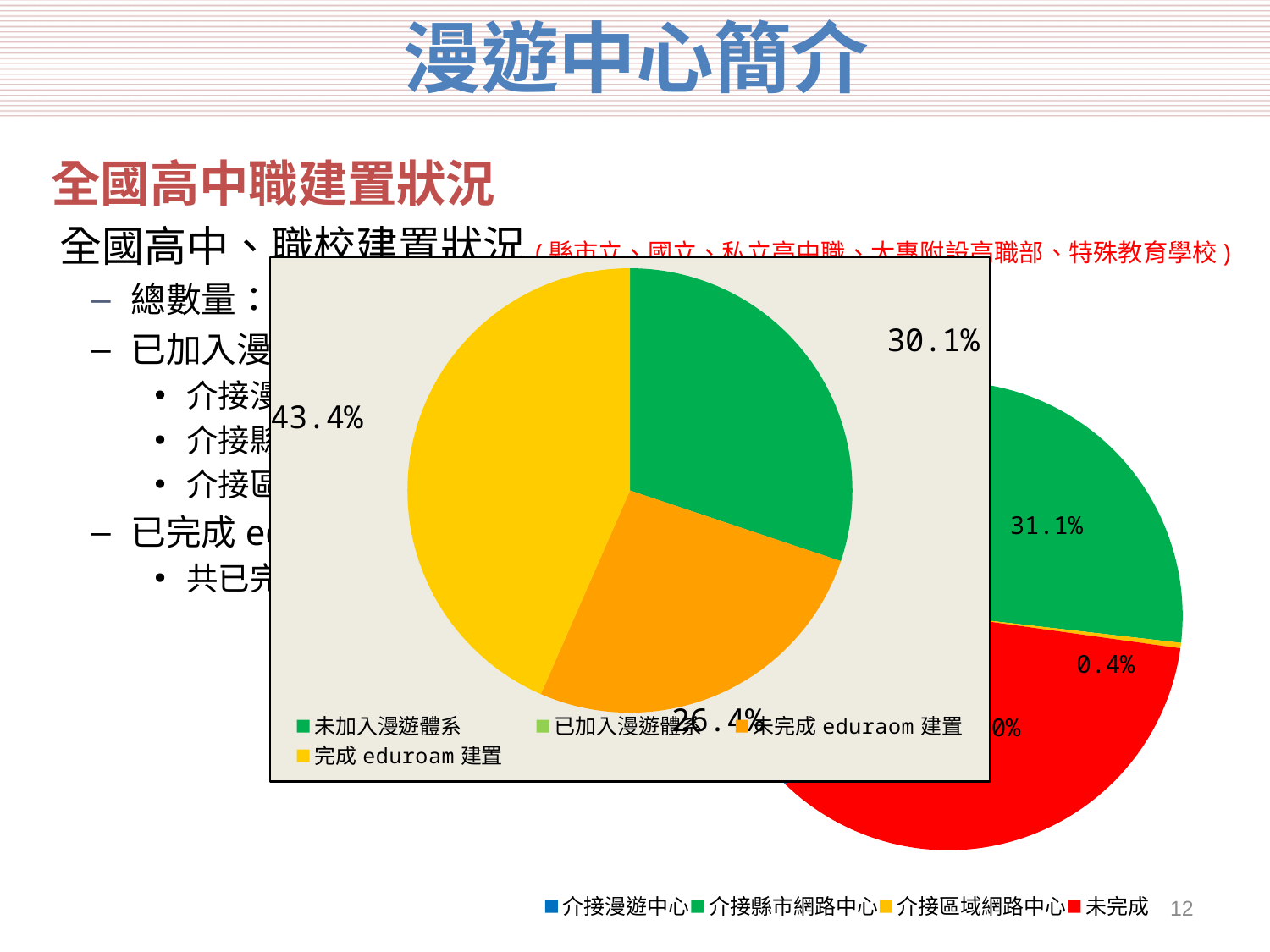
In the back pie chart (partially hidden, lower right), what percentage is shown for 介接縣市網路中心? 31.1% In the front pie chart (beige background), what is the difference in percentage points between 完成 eduroam 建置 and 未加入漫遊體系? 13.3 percentage points What type of chart is the front chart with the beige background? Pie chart In the front pie chart (beige background), which is larger: 未加入漫遊體系 or 未完成 eduraom 建置? 未加入漫遊體系 In the front pie chart (beige background), what percentage is shown for 未加入漫遊體系? 30.1% In the front pie chart (beige background), what percentage is shown for 未完成 eduraom 建置? 26.4% In the front pie chart (beige background), what percentage is shown for 完成 eduroam 建置? 43.4% In the back pie chart (partially hidden, lower right), what percentage is shown for 介接區域網路中心? 0.4% In the front pie chart (beige background), what colour is the 完成 eduroam 建置 slice? Yellow How many entries does the legend of the front pie chart (beige background) list? 4 In the front pie chart (beige background), which category has the largest slice? 完成 eduroam 建置